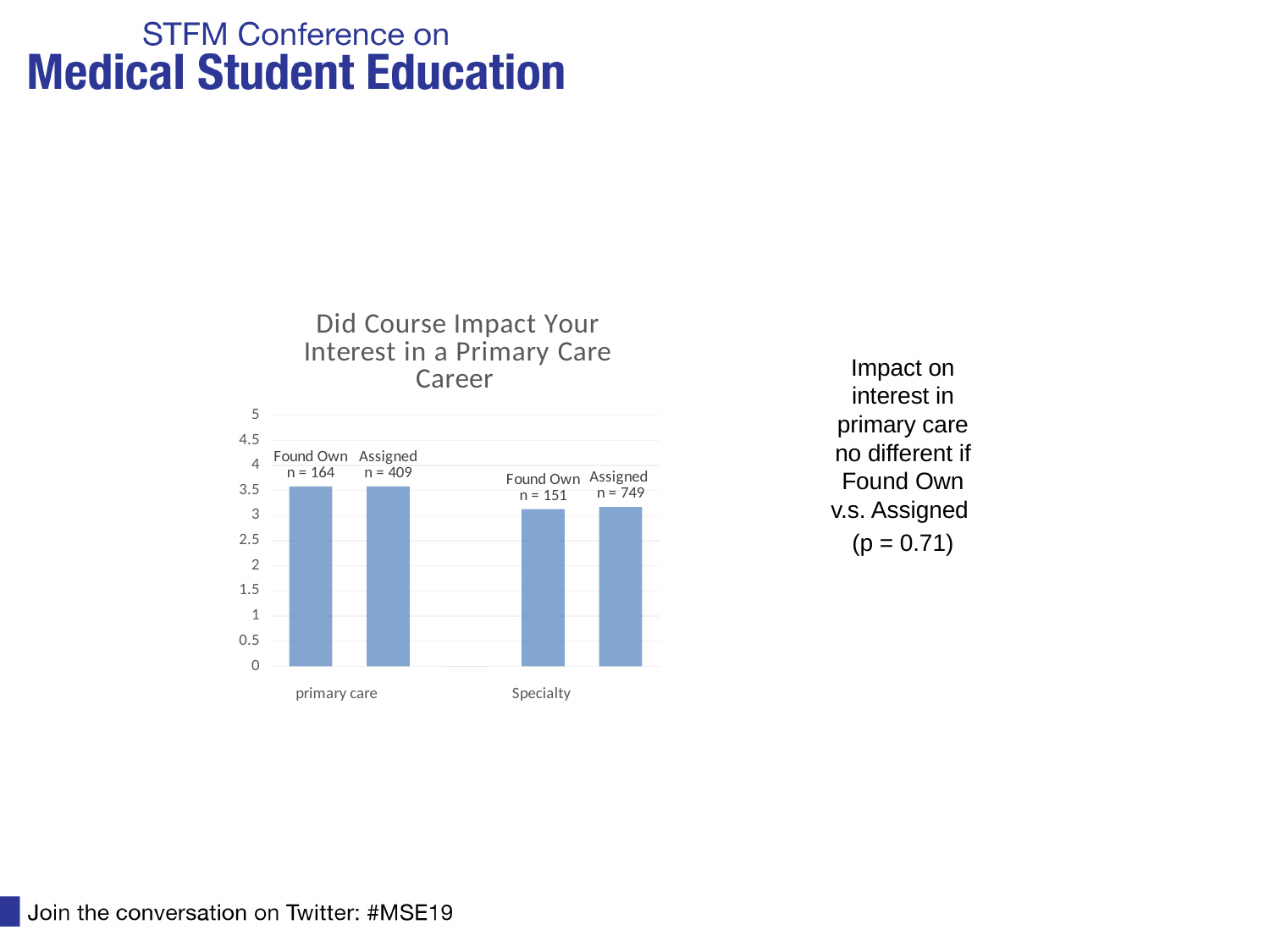
Which is larger: the Found Own bar for primary care or the Found Own bar for Specialty? Found Own for primary care What kind of chart is shown on the slide? bar chart Is the value for Assigned in the Specialty category greater or less than 3.5? less Is the value for Found Own in the primary care category greater or less than 3? greater What is the sample size (n) for the Assigned group in the primary care category? n = 409 How many categories are labelled on the x axis of the chart? 2 What is the sample size (n) for the Assigned group in the Specialty category? n = 749 What is the title of the chart? Did Course Impact Your Interest in a Primary Care Career What is the highest value shown on the y axis of the chart? 5 What is the sample size (n) for the Found Own group in the primary care category? n = 164 How many bars are plotted in the chart? 4 What is the sample size (n) for the Found Own group in the Specialty category? n = 151